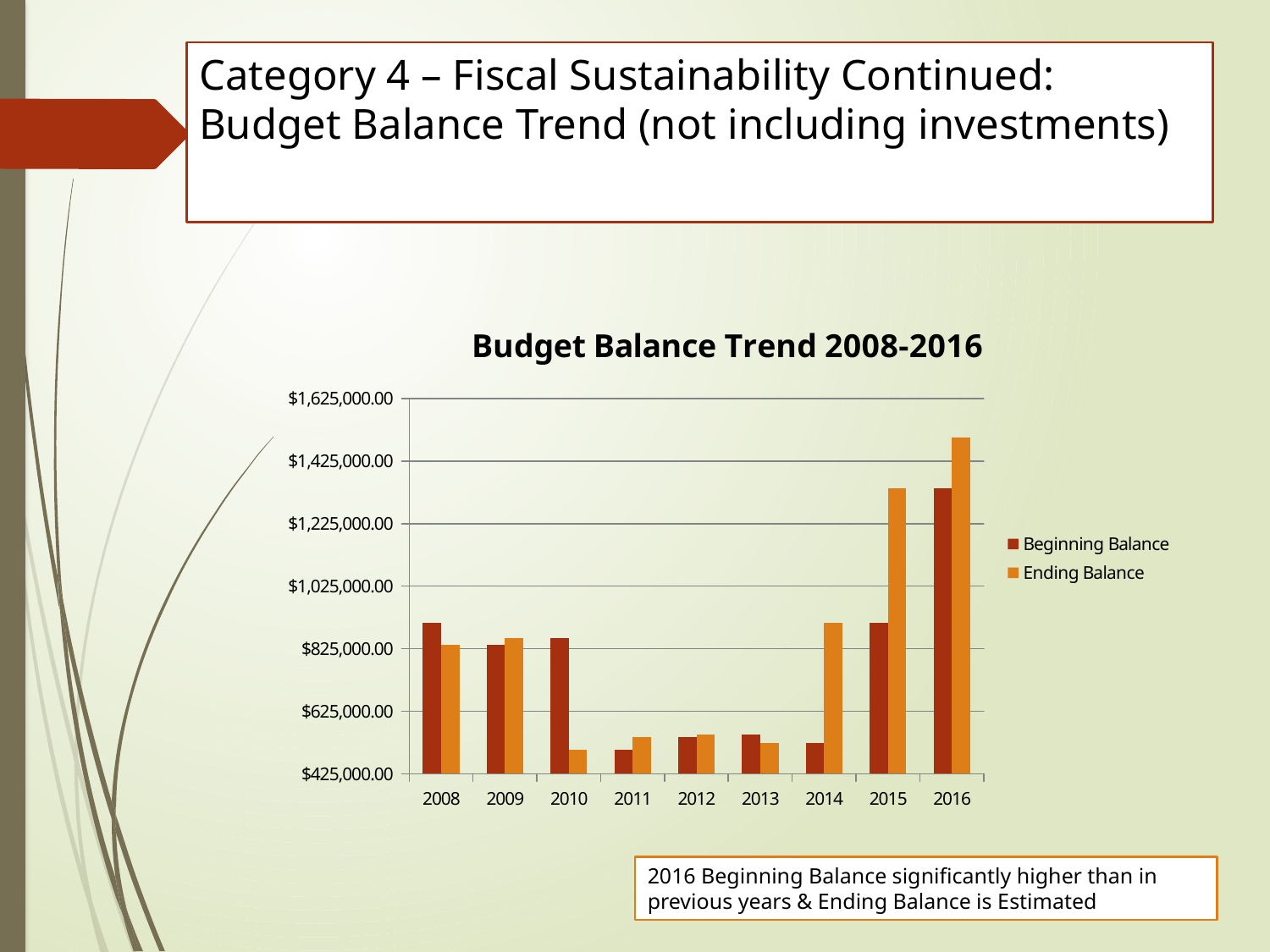
Is the Beginning Balance for 2014 greater or less than $625,000.00? less What is the title of the chart? Budget Balance Trend 2008-2016 How many series does the legend list? 2 Is the Ending Balance for 2010 greater or less than $625,000.00? less What kind of chart is shown on the slide? bar chart In which year is the Beginning Balance highest? 2016 For 2010, which is larger: the Beginning Balance or the Ending Balance? Beginning Balance Is the Ending Balance for 2016 greater or less than $1,425,000.00? greater For 2014, which is larger: the Beginning Balance or the Ending Balance? Ending Balance In which year is the Ending Balance highest? 2016 How many years are shown on the x axis of the chart? 9